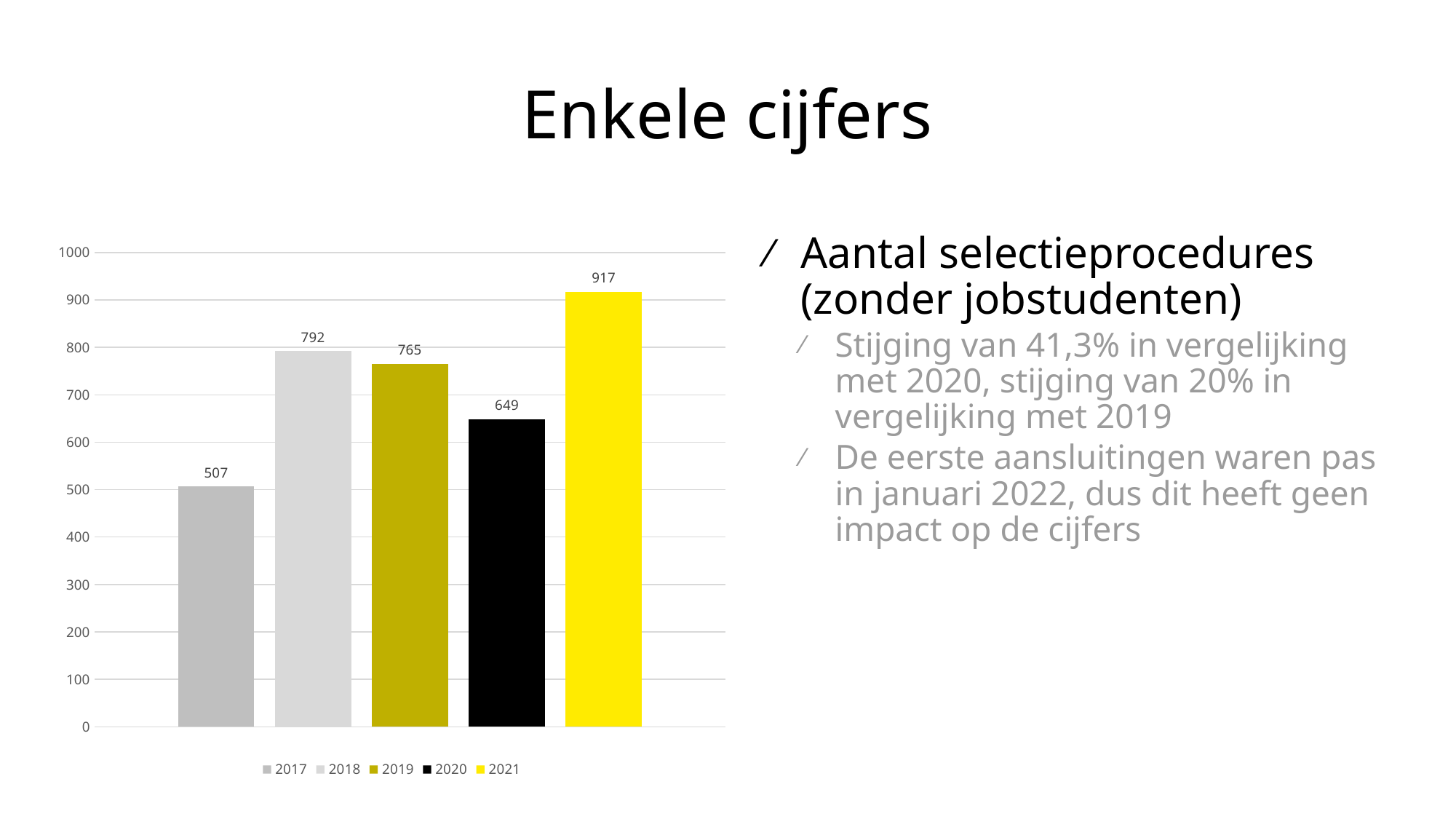
How many bars are shown in the chart? 5 Is the value for 2019 greater or less than 700? greater What kind of chart is shown on the slide? bar chart Which year has the highest value? 2021 What is the difference between the values for 2021 and 2020? 268 What is the value for 2020? 649 Which is larger, the value for 2018 or the value for 2020? 2018 Which year has the lowest value? 2017 What is the difference between the values for 2018 and 2019? 27 What is the value for 2017? 507 What is the value for 2021? 917 How many entries does the legend list? 5